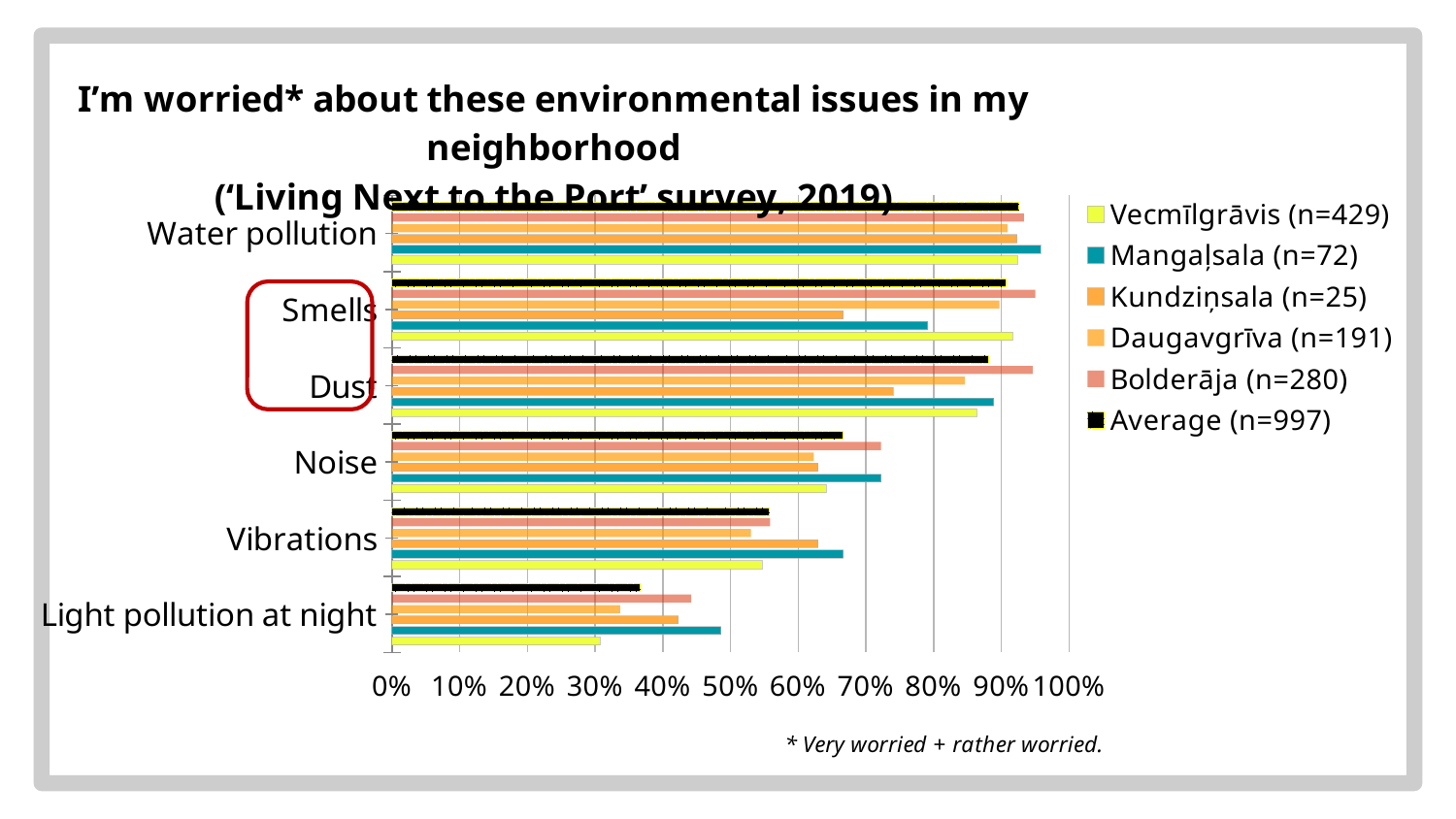
Is the Kundziņsala value for Smells greater or less than 70%? less Which environmental issue has the lowest Average value? Light pollution at night Which environmental issue has the highest Mangaļsala value? Water pollution Is the Vecmīlgrāvis value for Vibrations greater or less than 60%? less Is the Mangaļsala value for Water pollution greater or less than 90%? greater Do the Average values rise or fall going down the chart from Water pollution to Light pollution at night? fall What kind of chart is shown on the slide? bar chart What is the sample size (n) shown in the legend for the Average series? n=997 How many series does the legend list? 6 For Smells, which is larger: the Kundziņsala value or the Mangaļsala value? Mangaļsala How many environmental issues (categories) are listed on the chart? 6